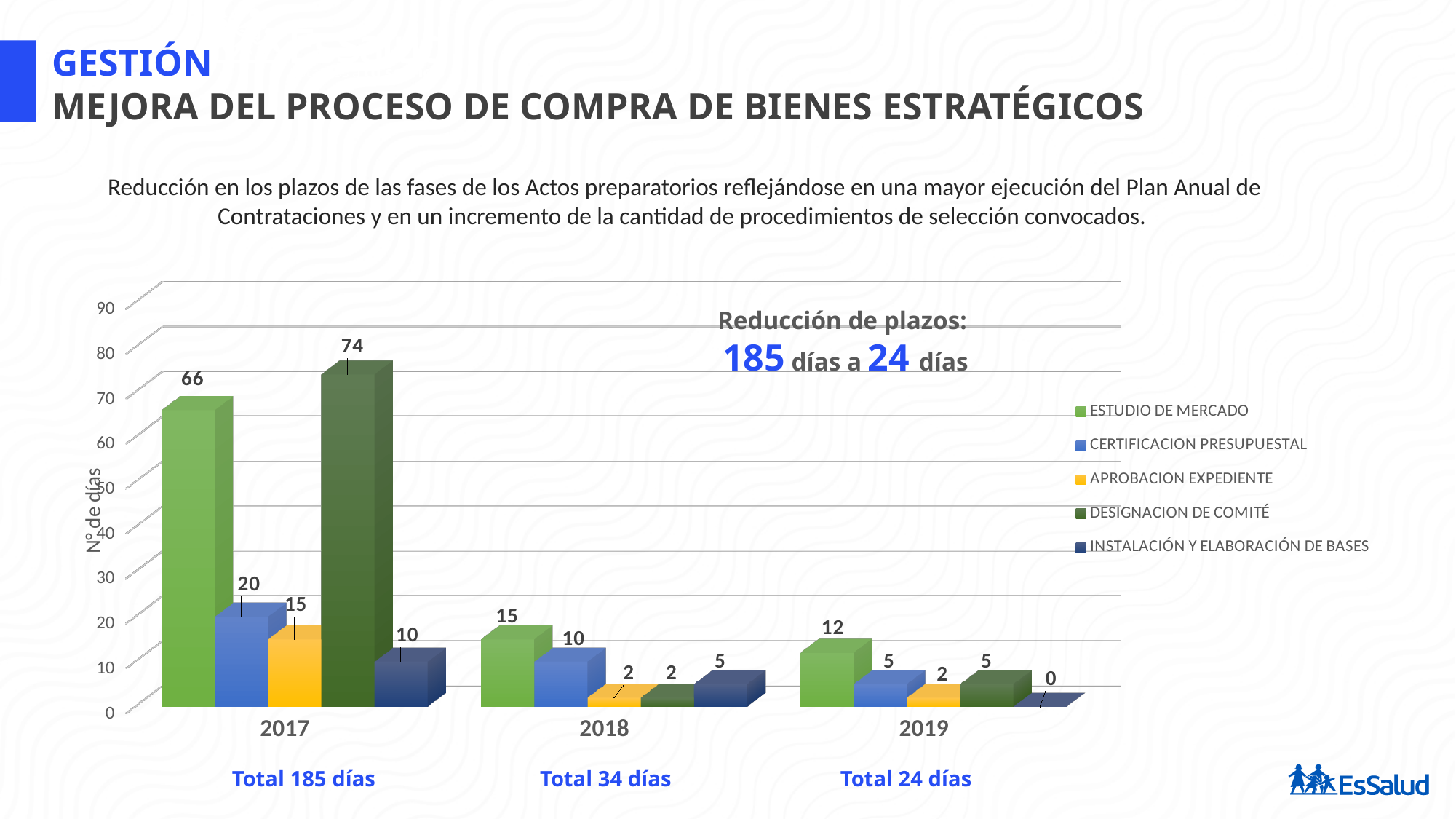
What is the value for ESTUDIO DE MERCADO in 2017? 66 What kind of chart is shown on the slide? Bar chart Which is larger: APROBACION EXPEDIENTE in 2017 or INSTALACIÓN Y ELABORACIÓN DE BASES in 2017? APROBACION EXPEDIENTE in 2017 How many series does the legend list? 5 What is the value for DESIGNACION DE COMITÉ in 2017? 74 What is the value for INSTALACIÓN Y ELABORACIÓN DE BASES in 2019? 0 Which series has the lowest value in 2019? INSTALACIÓN Y ELABORACIÓN DE BASES What is the difference between the ESTUDIO DE MERCADO values for 2017 and 2019? 54 How many years are shown on the x axis? 3 Does the value for ESTUDIO DE MERCADO rise or fall from 2017 to 2019? Fall Which series has the highest value in 2017? DESIGNACION DE COMITÉ What is the value for CERTIFICACION PRESUPUESTAL in 2018? 10